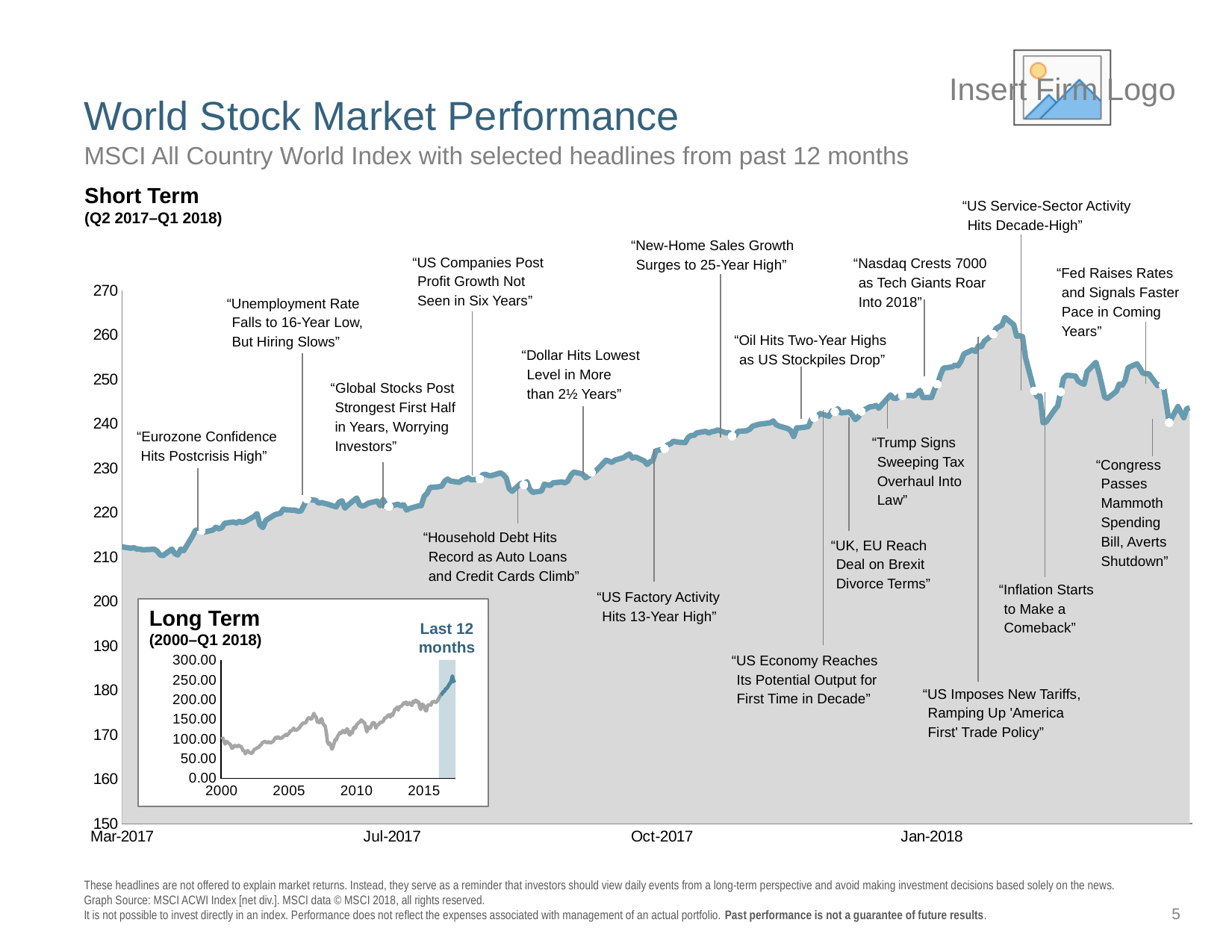
What kind of chart is the Short Term chart on the slide? line chart (with shaded area) On the Short Term chart, is the value at Mar-2017 greater or less than 220? less On the Long Term chart, which is larger: the value at 2000 or the value at 2015? 2015 How many date labels are shown on the x axis of the Short Term chart? 4 On the Short Term chart, which is larger: the value at Mar-2017 or the value at Jan-2018? Jan-2018 On the Long Term chart, is the value at 2015 greater or less than 150? greater On the Short Term chart, is the value at Jan-2018 greater or less than 240? greater On the Short Term chart, does the index generally rise or fall from Mar-2017 to Jan-2018? rise On the Long Term chart, does the index generally rise or fall from 2000 to the end of the series? rise What kind of chart is the Long Term inset chart? line chart What period does the Long Term chart cover, according to its subtitle? 2000–Q1 2018